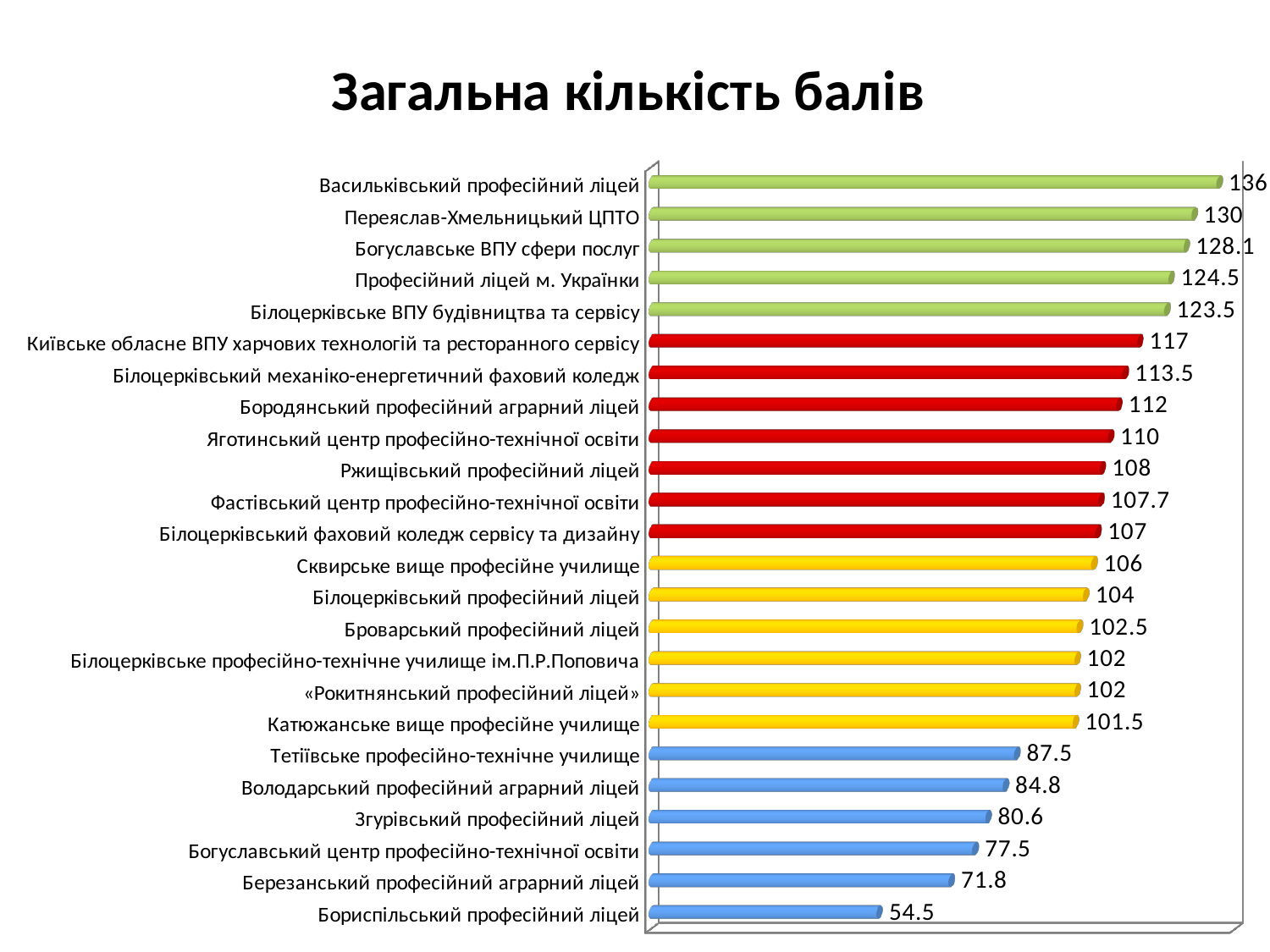
What is the difference between the values for Васильківський професійний ліцей and Переяслав-Хмельницький ЦПТО? 6 What is the value for Фастівський центр професійно-технічної освіти? 107.7 What is the value for Васильківський професійний ліцей? 136 What type of chart is shown on the slide? bar chart How many categories (institutions) are plotted in the chart? 24 What is the title of the chart? Загальна кількість балів What is the value for Бориспільський професійний ліцей? 54.5 Which has a larger value: Тетіївське професійно-технічне училище or Згурівський професійний ліцей? Тетіївське професійно-технічне училище What is the difference between the values for Березанський професійний аграрний ліцей and Бориспільський професійний ліцей? 17.3 Which institution has the highest value? Васильківський професійний ліцей Which institution has the lowest value? Бориспільський професійний ліцей What is the value for Богуславське ВПУ сфери послуг? 128.1